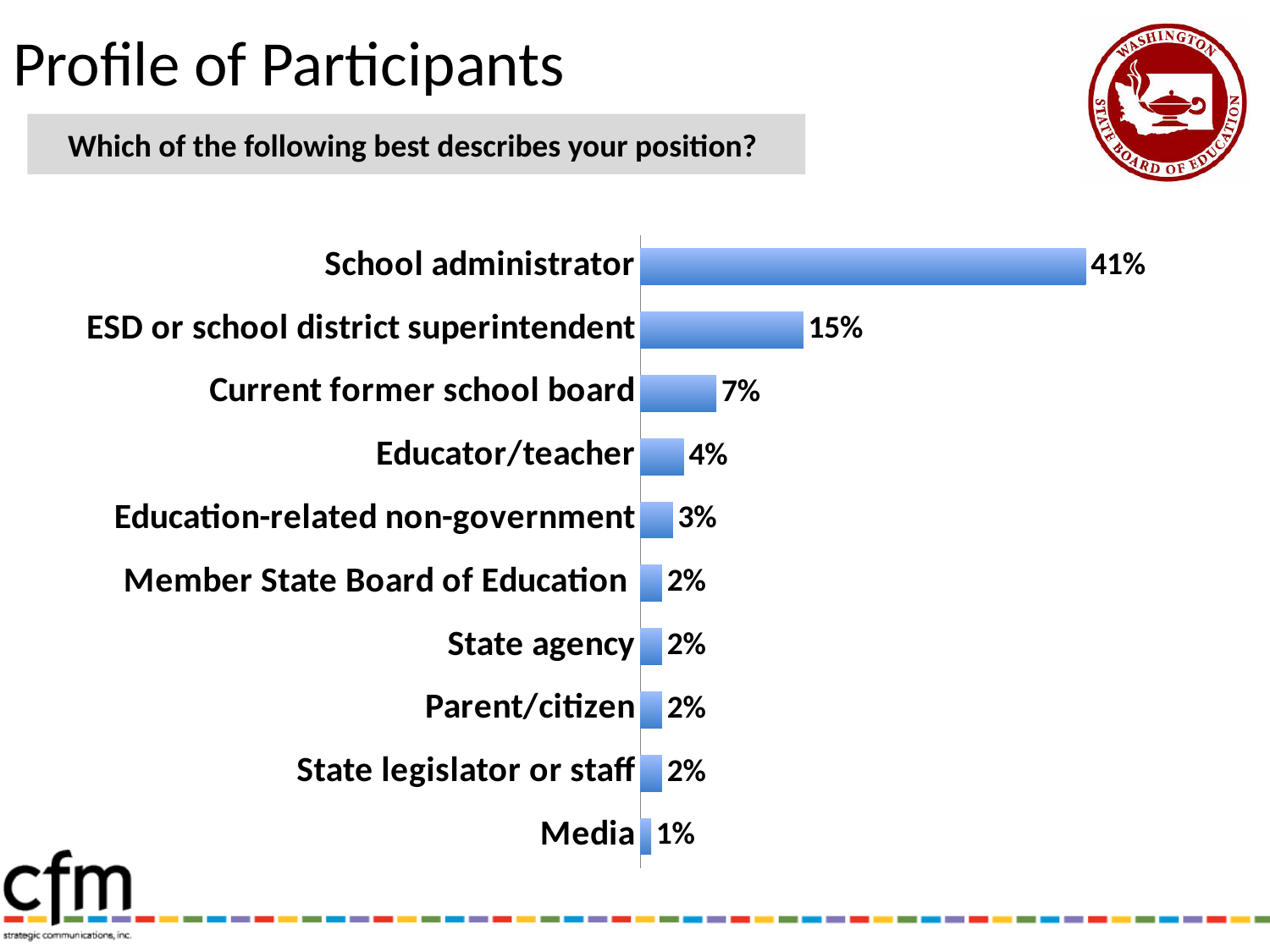
What percentage of participants are school administrators? 41% Which category has the lowest value? Media What is the difference between Current former school board and Educator/teacher? 3% What percentage of participants are educators/teachers? 4% What question is the chart based on, as shown in the grey box? Which of the following best describes your position? What is the value for ESD or school district superintendent? 15% How many categories are shown in the chart? 10 What is the value for Media? 1% What is the difference between School administrator and ESD or school district superintendent? 26% Which category has the highest value? School administrator What kind of chart is shown on the slide? Bar chart Which is larger, Current former school board or Education-related non-government? Current former school board